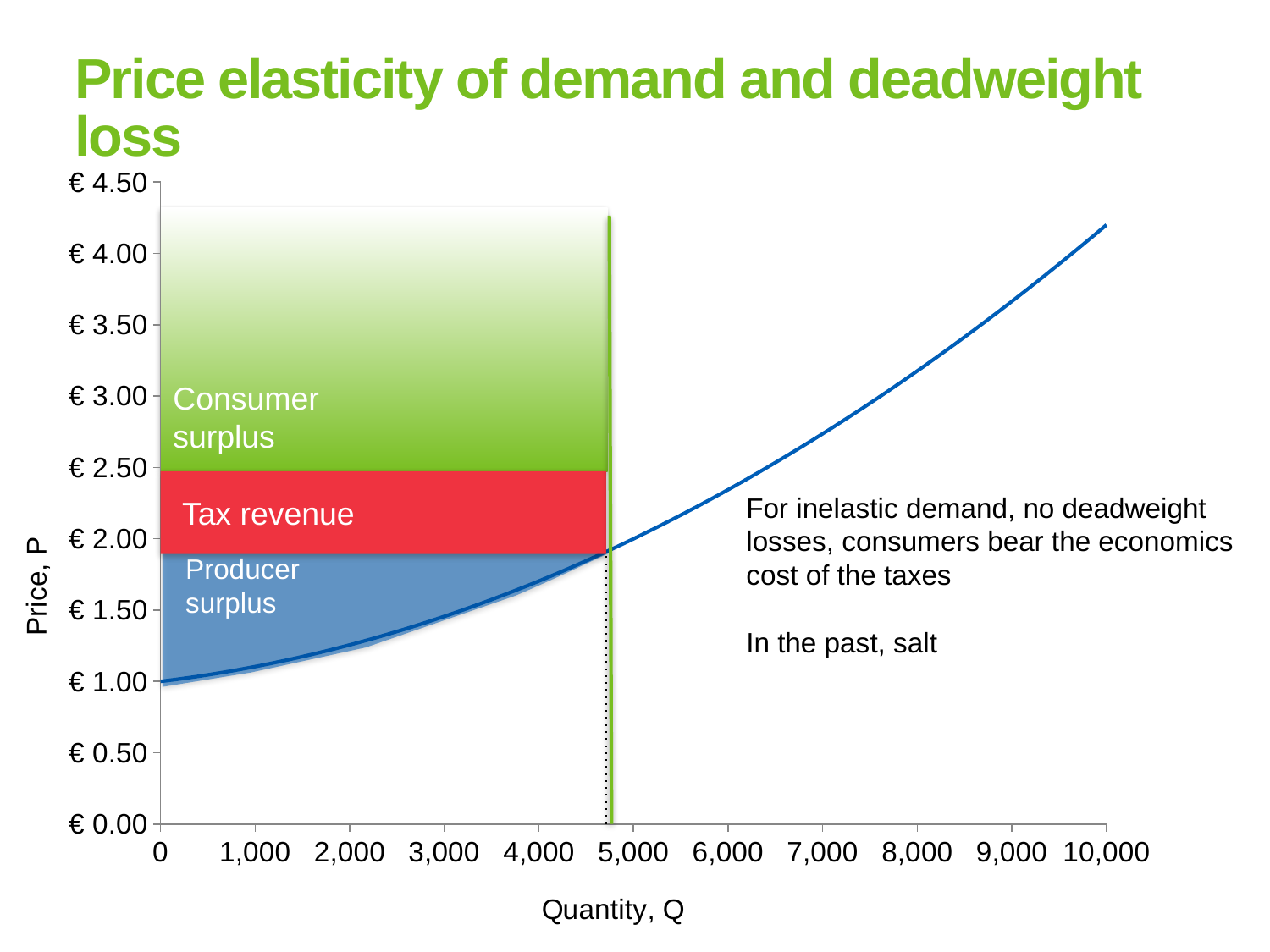
Is the price on the curve at a quantity of 0 greater or less than € 1.50? less Does the plotted curve rise or fall as quantity increases along the x axis? rise Is the price on the curve at a quantity of 10,000 greater or less than € 4.00? greater Is the price on the curve at a quantity of 8,000 greater or less than € 3.00? greater What is the highest value shown on the x axis of the chart? 10,000 Which is larger: the price on the curve at a quantity of 10,000 or at a quantity of 0? 10,000 What is the highest value shown on the y axis of the chart? € 4.50 What kind of chart is shown on the slide? line chart What does the red shaded region of the chart represent? Tax revenue